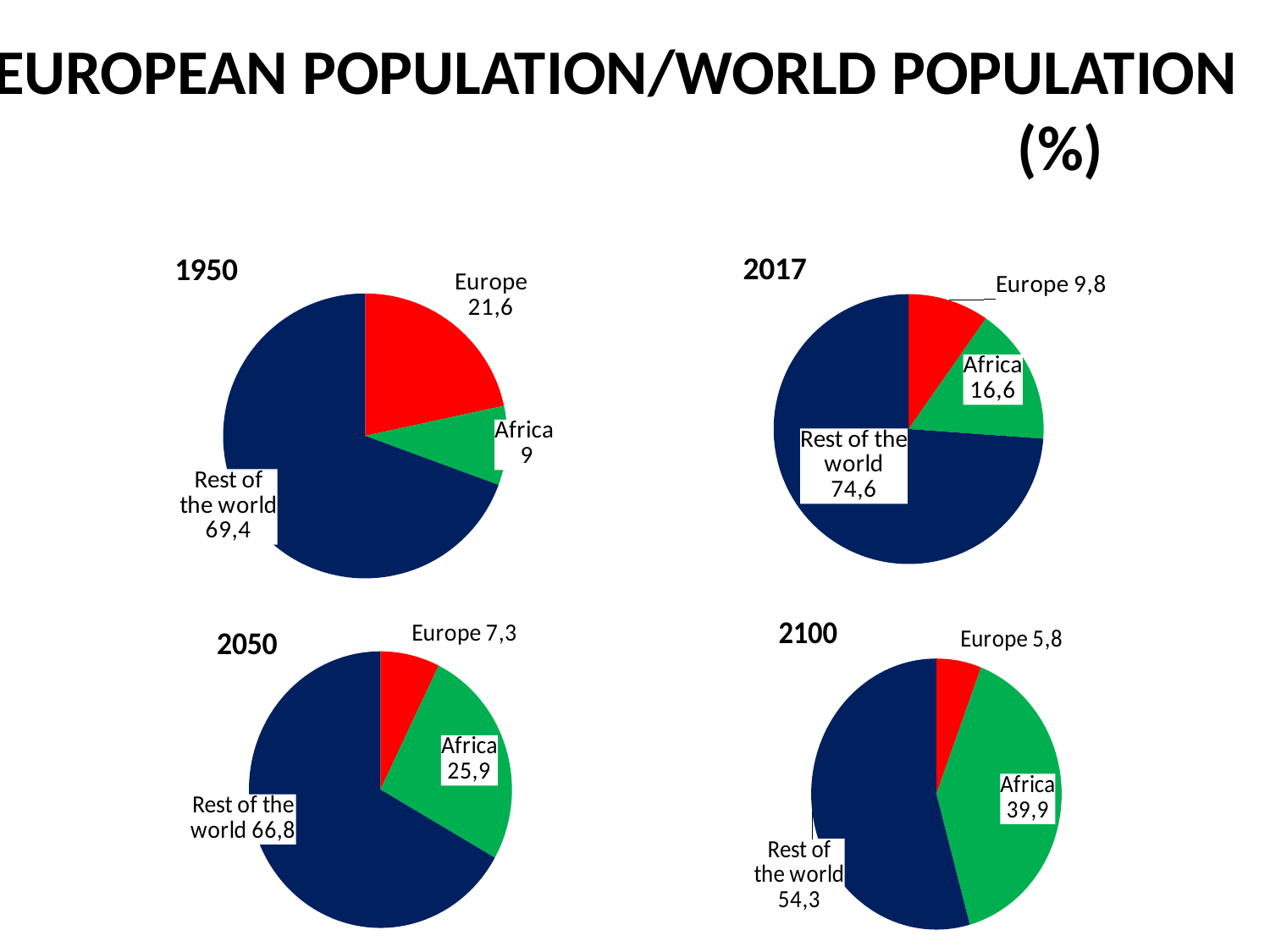
How many slices does the 2100 pie chart have? 3 Across the four pie charts from 1950 to 2100, does the value for Europe rise or fall over time? Fall In the 1950 pie chart, what is the value for Europe? 21,6 In the 2100 pie chart, which category has the largest slice? Rest of the world In the 2017 pie chart, which is larger, Europe or Africa? Africa In the 2017 pie chart, what is the value for Africa? 16,6 In the 1950 pie chart, which category has the smallest slice? Africa In the 2050 pie chart, what is the value for Rest of the world? 66,8 What kind of chart is used for the 1950 data? Pie chart In the 2050 pie chart, what is the difference between the values for Africa and Europe? 18,6 In the 2100 pie chart, what is the value for Europe? 5,8 How many pie charts are shown on the slide? 4